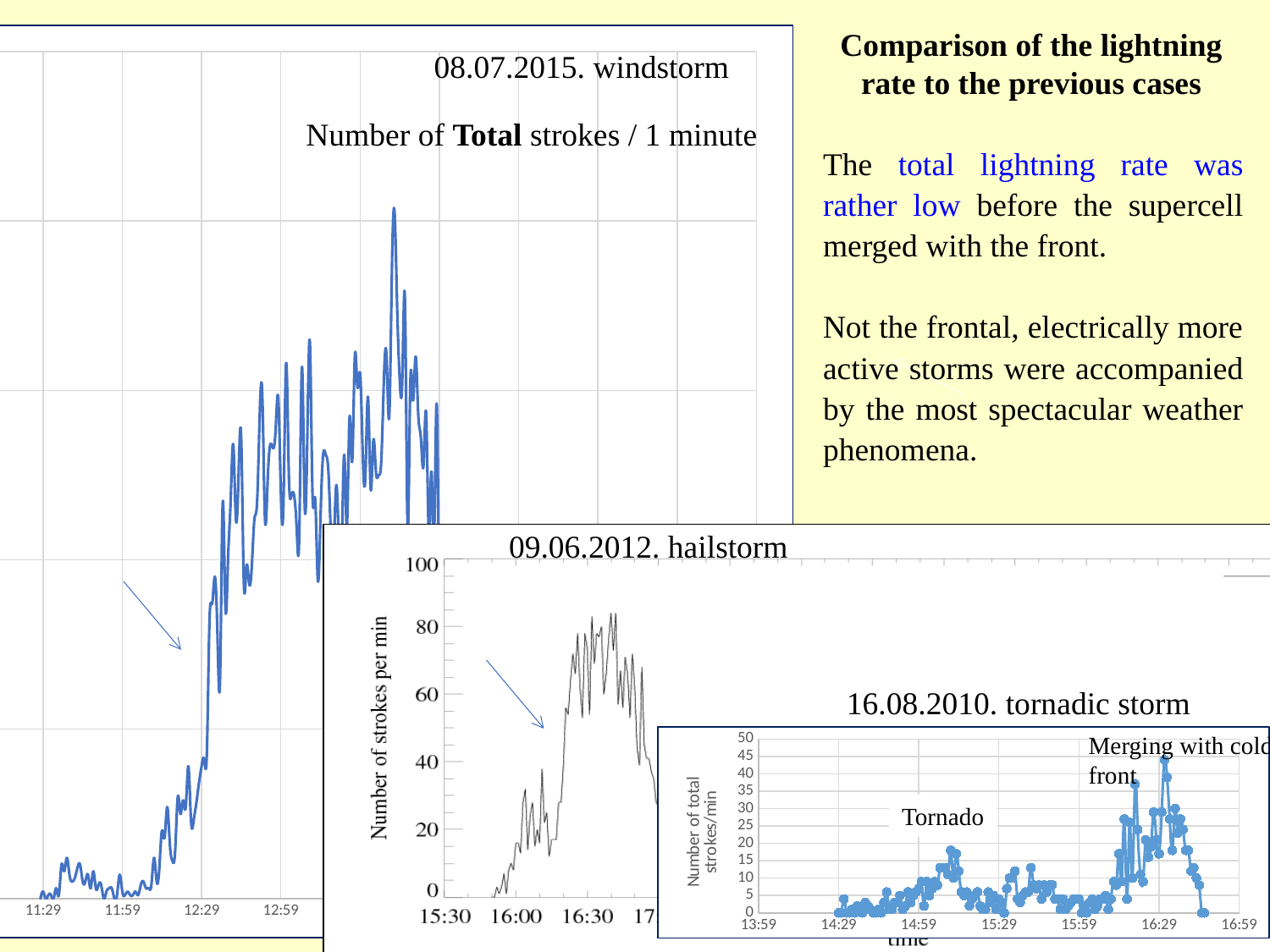
In the '09.06.2012. hailstorm' chart, is the peak value greater or less than 60? greater In the '08.07.2015. windstorm' chart, what is the first time label shown on the x axis? 11:29 What kind of chart is the '16.08.2010. tornadic storm' chart? line chart In the '16.08.2010. tornadic storm' chart, is the peak value near 16:29 greater or less than 30? greater What kind of chart is the '09.06.2012. hailstorm' chart? line chart In the '08.07.2015. windstorm' chart, do the values generally rise or fall from 11:29 to 12:59? rise In the '16.08.2010. tornadic storm' chart, what is the highest value shown on the y axis? 50 In the '09.06.2012. hailstorm' chart, what is the label on the y axis? Number of strokes per min How many charts are shown on the slide? 3 In the '16.08.2010. tornadic storm' chart, is the peak value around the 'Tornado' annotation (near 15:00) greater or less than 25? less In the '16.08.2010. tornadic storm' chart, which peak is higher: the one labelled 'Tornado' or the one labelled 'Merging with cold front'? Merging with cold front